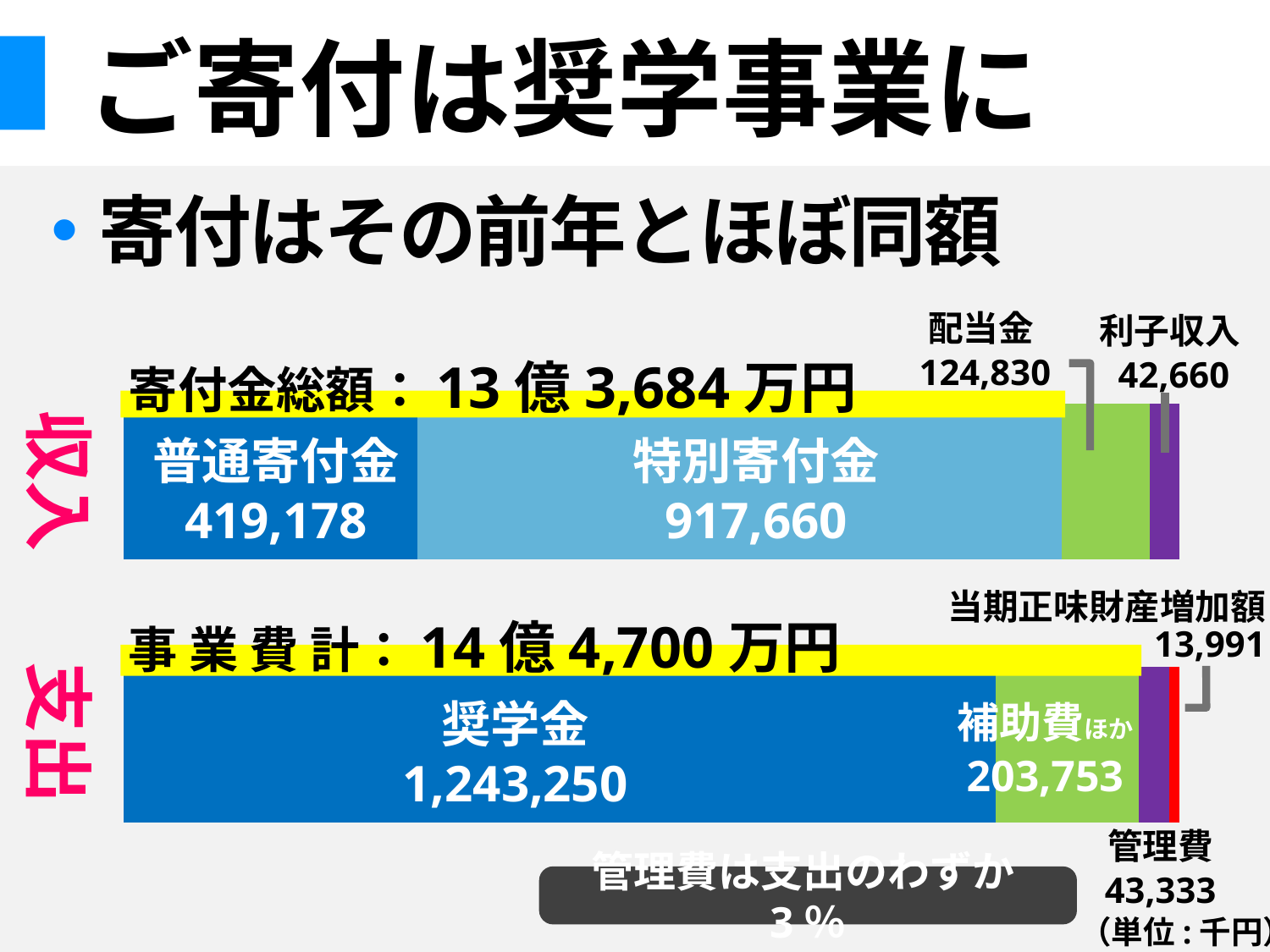
In the 支出 bar, which segment has the smallest value? 当期正味財産増加額 What kind of chart is used to show 収入 and 支出 on this slide? Stacked bar chart In the 収入 bar, what is the value for 配当金? 124,830 In the 支出 bar, what is the value for 管理費? 43,333 In the 収入 bar, what is the difference between 特別寄付金 and 普通寄付金? 498,482 In the 支出 bar, what is the value for 奨学金? 1,243,250 In the 支出 bar, which is larger, 補助費ほか or 管理費? 補助費ほか In the 収入 bar, what is the value for 特別寄付金? 917,660 In the 収入 bar, which segment has the smallest value? 利子収入 In the 収入 bar, what is the value for 普通寄付金? 419,178 In the 収入 bar, which segment has the largest value? 特別寄付金 What is the combined value of 普通寄付金 and 特別寄付金 in the 収入 bar? 1,336,838